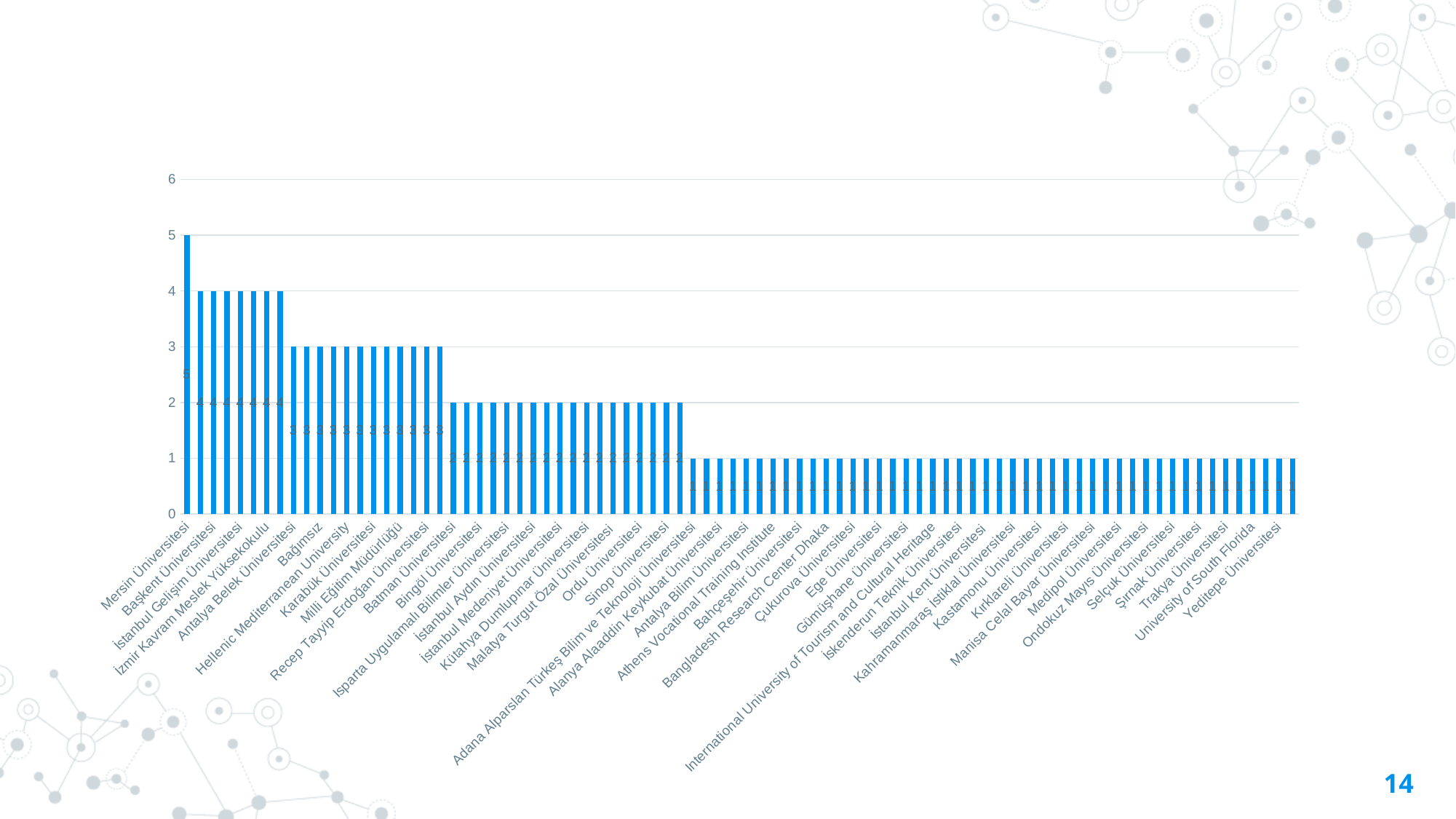
What is the highest value shown on the vertical axis? 6 What is the value for Karabük Üniversitesi? 3 Which category has the highest value in the bar chart? Mersin Üniversitesi Which has a larger value, Mersin Üniversitesi or Karabük Üniversitesi? Mersin Üniversitesi What is the value for Yeditepe Üniversitesi? 1 Is the value for Mersin Üniversitesi greater or less than 4? greater What is the value for Mersin Üniversitesi? 5 Do the values rise or fall moving from left to right along the x axis? Fall What kind of chart is shown on the slide? Bar chart What is the value for Başkent Üniversitesi? 4 What is the value for Ordu Üniversitesi? 2 What is the difference between the values for Mersin Üniversitesi and Başkent Üniversitesi? 1